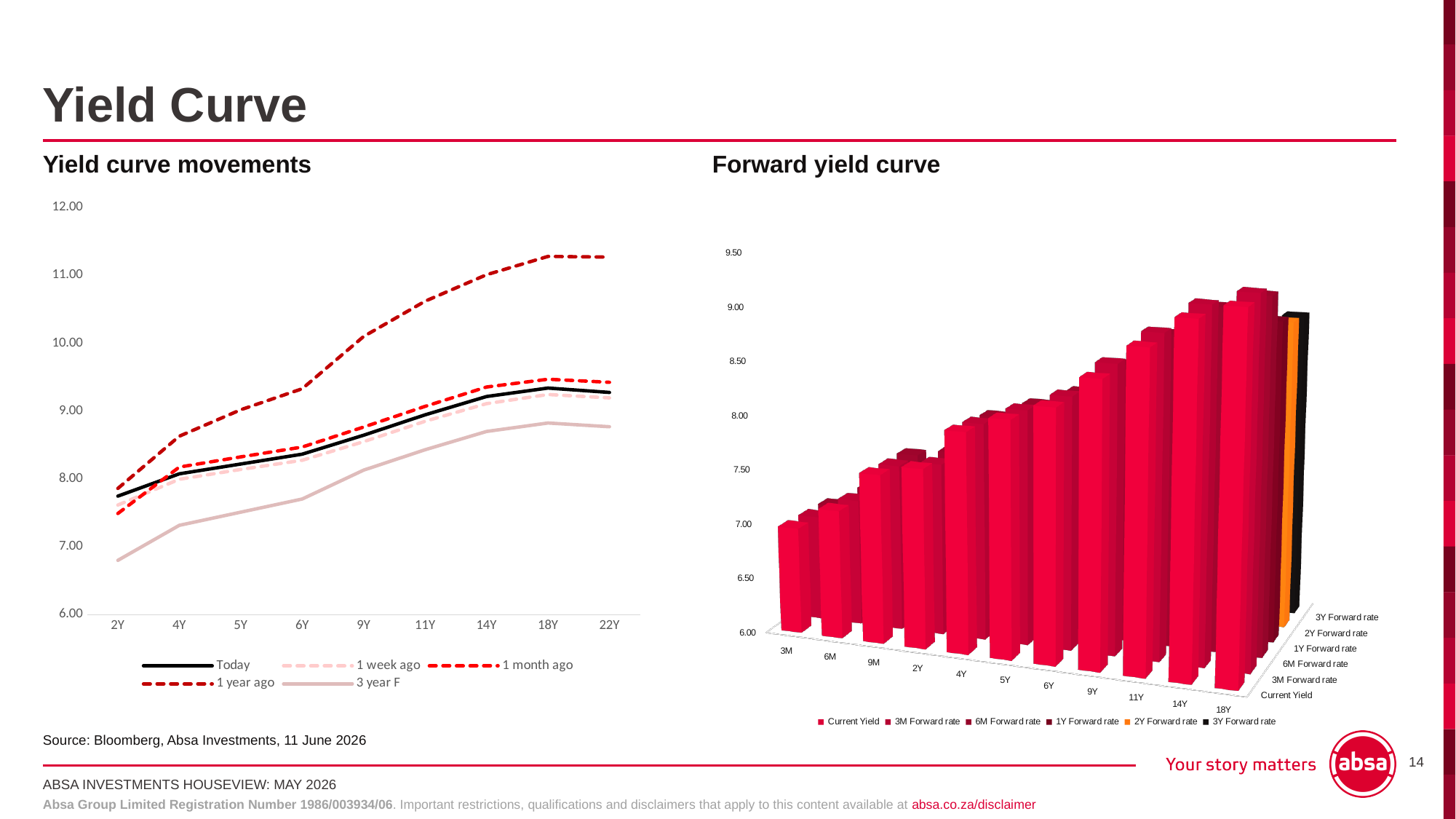
How many series does the legend of the "Forward yield curve" chart list? 6 In the "Yield curve movements" chart, is the Today value at 2Y greater or less than 8.00? less How many maturity points are shown on the x axis of the "Yield curve movements" chart? 9 In the "Forward yield curve" chart, which maturity has the lowest Current Yield? 3M How many series does the legend of the "Yield curve movements" chart list? 5 In the "Yield curve movements" chart, is the 1 year ago value at 22Y greater or less than 11.00? greater In the "Yield curve movements" chart, which series is lowest at 2Y? 3 year F In the "Yield curve movements" chart, which series is highest at 22Y? 1 year ago What kind of chart is the "Forward yield curve" chart? bar chart In the "Forward yield curve" chart, does the Current Yield rise or fall from 3M to 18Y? rise What kind of chart is the "Yield curve movements" chart? line chart How many maturity categories are shown on the x axis of the "Forward yield curve" chart? 11